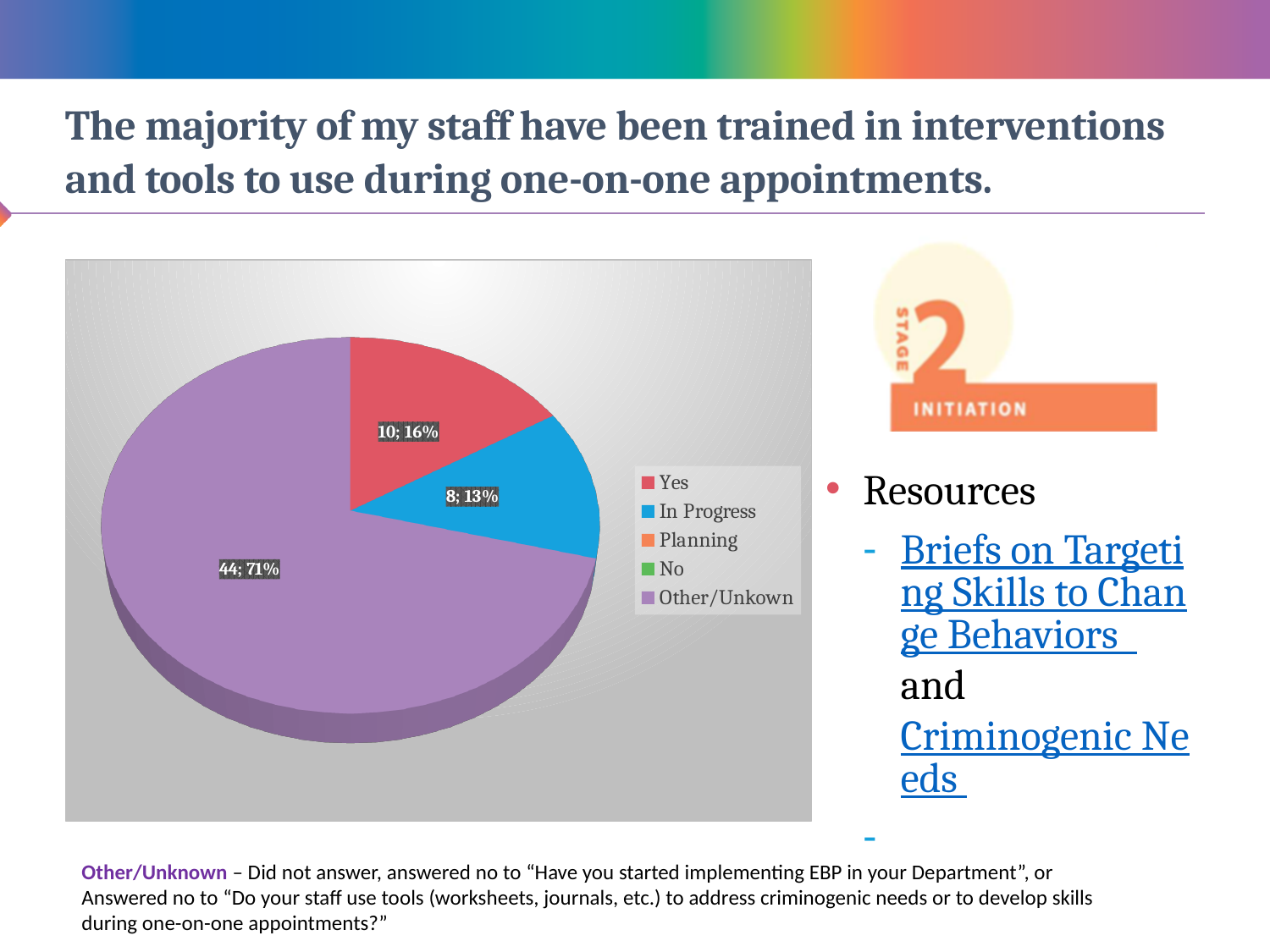
How many entries does the legend of the pie chart list? 5 What kind of chart is shown on the slide? pie chart What is the difference in count between the Other/Unknown slice and the Yes slice? 34 Which of the visible slices is the smallest? In Progress Which legend entries have no visible slice in the pie? Planning and No Which slice is larger, Yes or In Progress? Yes Which category has the largest slice of the pie? Other/Unknown What colour is the Other/Unknown slice in the pie chart? purple What count and percentage are shown for the Other/Unknown slice? 44; 71% What share of the pie does the Yes slice represent? 16% What count and percentage are shown for the In Progress slice? 8; 13% What count and percentage are shown for the Yes slice? 10; 16%